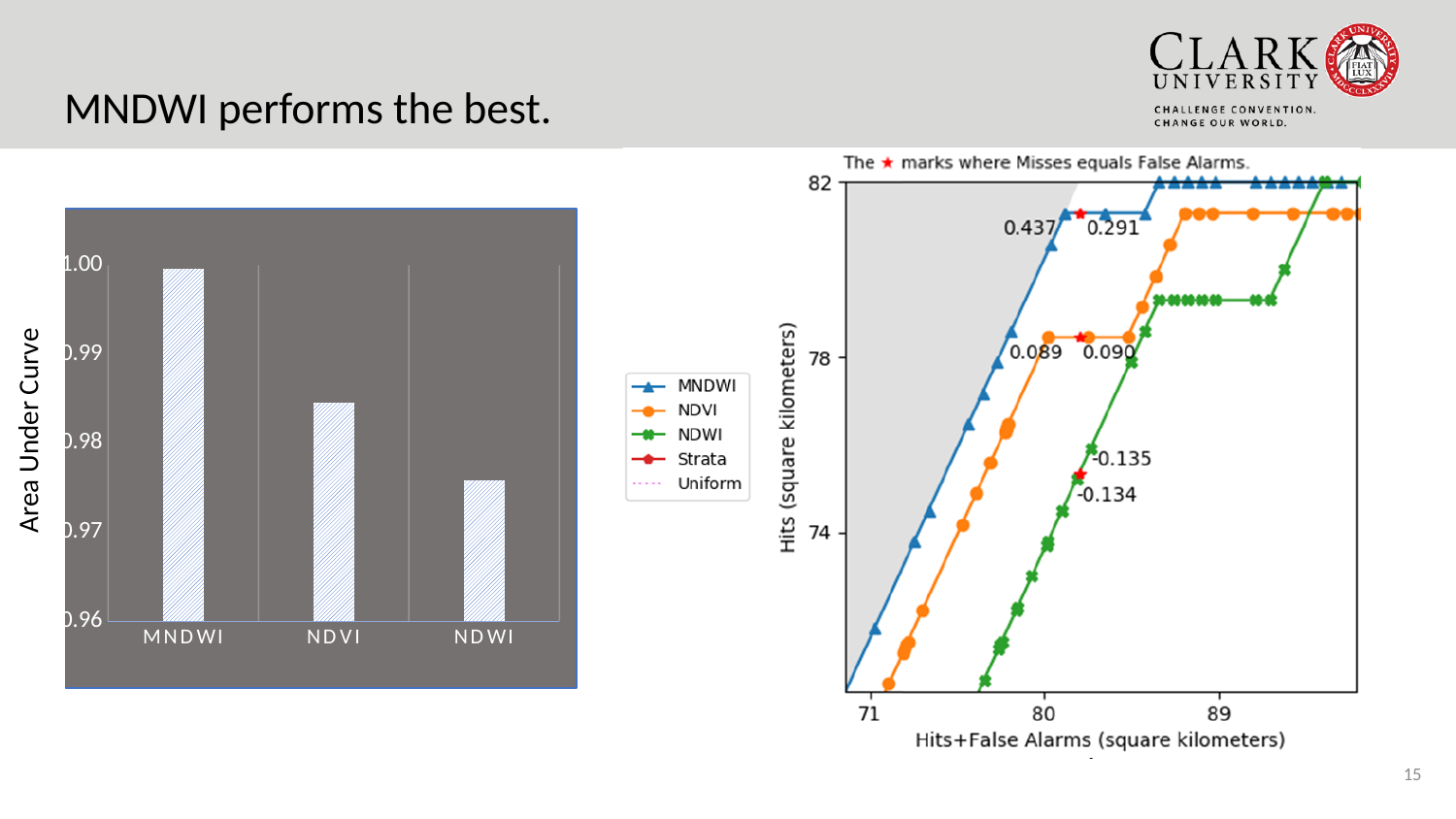
In the bar chart on the left, is the value for MNDWI greater or less than 0.99? greater In the bar chart on the left, how many categories are shown on the x axis? 3 In the bar chart on the left, which category has the highest Area Under Curve? MNDWI What kind of chart is the chart on the left of the slide? bar chart In the chart on the right, how many series does the legend list? 5 In the bar chart on the left, which has the larger Area Under Curve, NDVI or NDWI? NDVI In the bar chart on the left, is the value for NDVI greater or less than 0.98? greater In the bar chart on the left, is the value for NDWI greater or less than 0.98? less What kind of chart is the chart on the right of the slide? line chart In the chart on the right, what is the label of the y axis? Hits (square kilometers) In the bar chart on the left, which category has the lowest Area Under Curve? NDWI